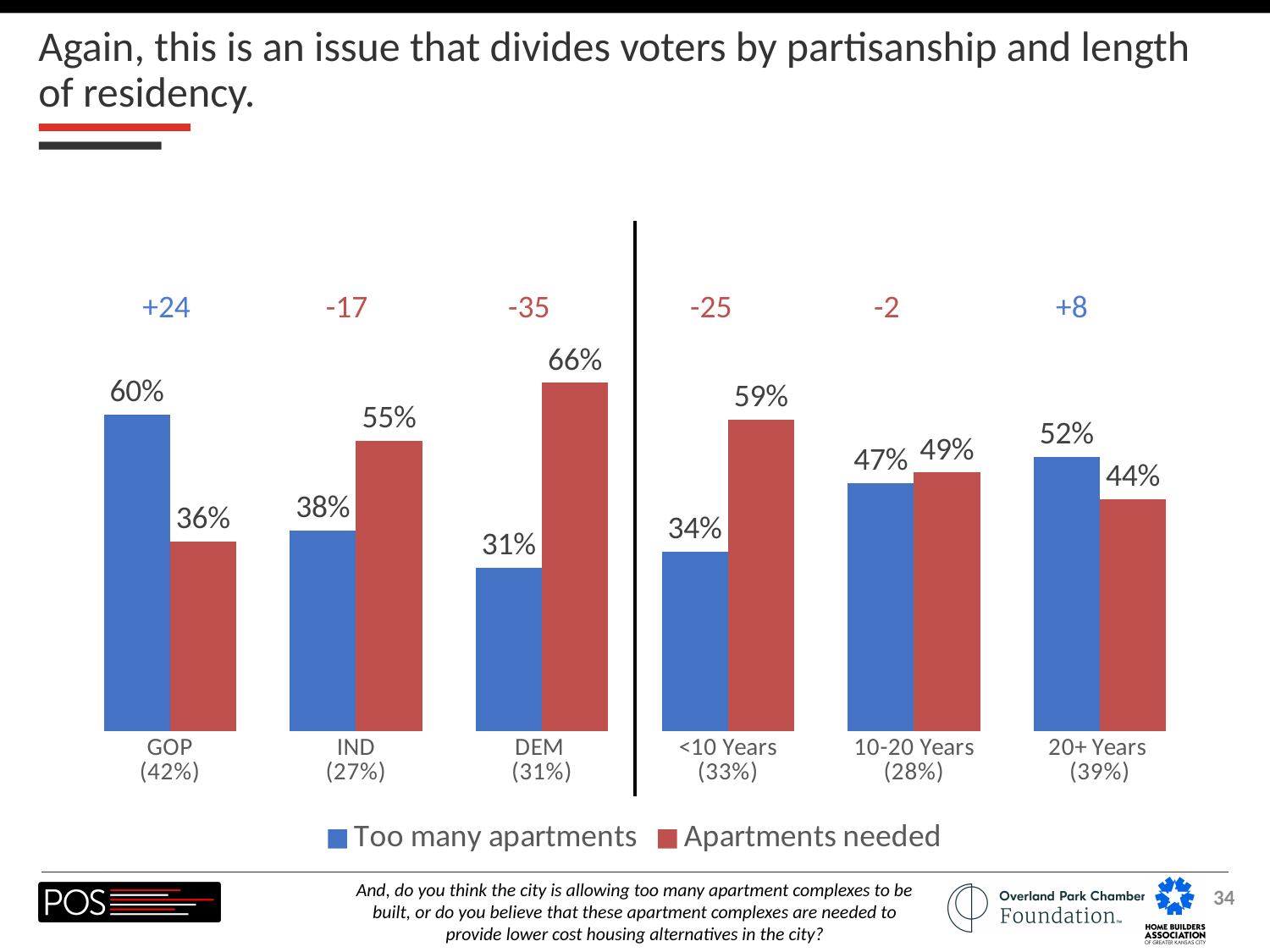
What percentage of GOP voters say there are too many apartments? 60% For residents of 20+ Years, which is larger: 'Too many apartments' or 'Apartments needed'? Too many apartments What colour represents the 'Apartments needed' series? Red What is the difference between 'Apartments needed' and 'Too many apartments' for IND voters? 17 How many series does the legend list? 2 Which category has the lowest 'Too many apartments' value? DEM What percentage of DEM voters say apartments are needed? 66% How many categories are shown on the x axis? 6 What is the value for 'Apartments needed' among residents of 10-20 Years? 49% Which category has the highest 'Apartments needed' value? DEM What kind of chart is shown on the slide? Bar chart What is the net difference shown above the <10 Years category? -25